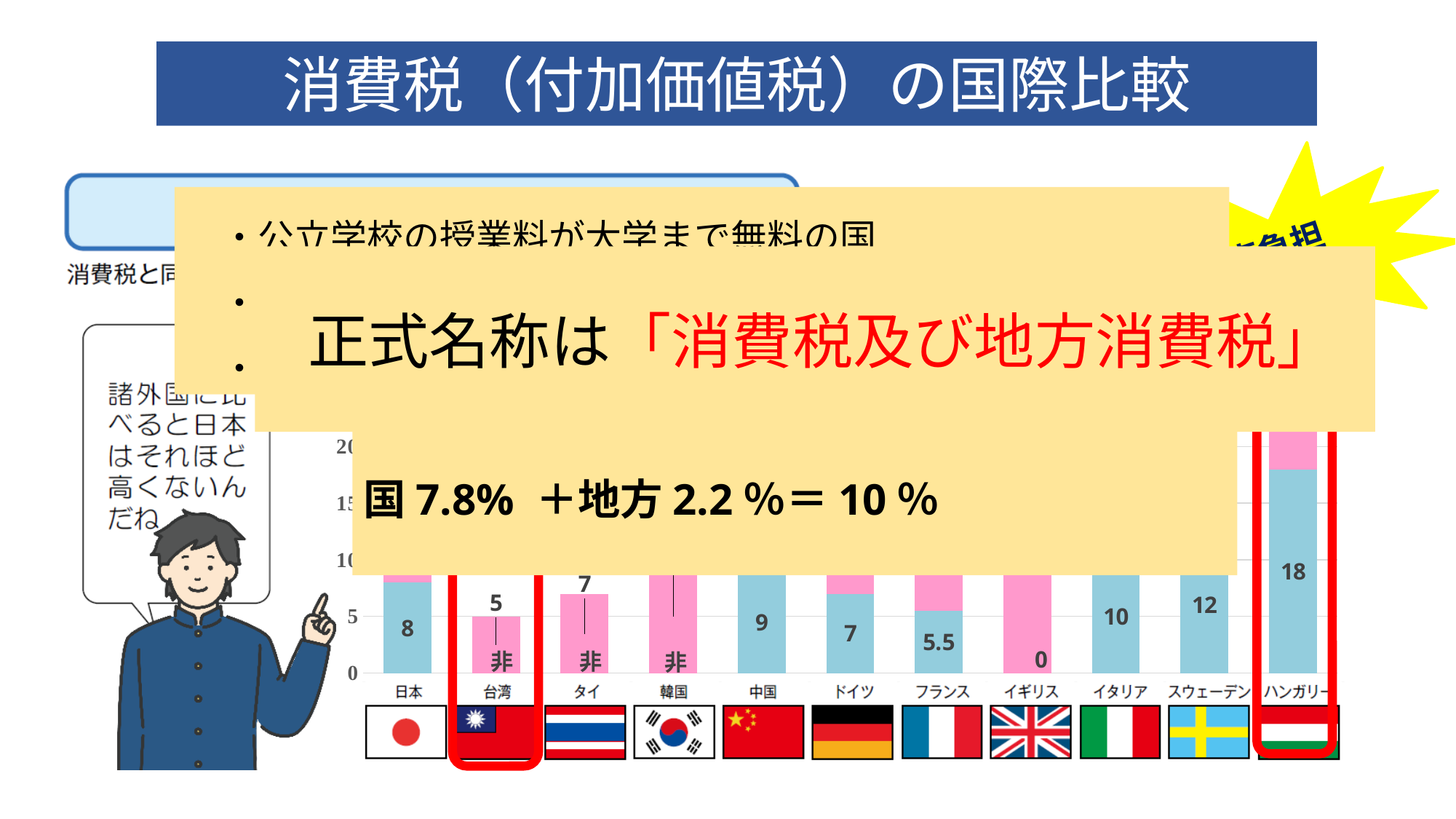
What is the difference between the printed values for スウェーデン (12) and イタリア (10)? 2 What number is printed on the bar for イギリス (UK)? 0 How many countries are shown along the x axis of the bar chart? 11 What number is printed on the bar for スウェーデン (Sweden)? 12 What number is printed on the bar for フランス (France)? 5.5 What number is printed on the bar for 中国 (China)? 9 What number is printed on the bar for 日本 (Japan)? 8 Is the total height of the bar for ハンガリー greater or less than 20? greater What kind of chart is shown at the bottom of the slide? bar chart Which country has the highest printed value on its bar? ハンガリー What number is printed on the bar for ハンガリー (Hungary)? 18 Which country has the lowest printed value on its bar? イギリス